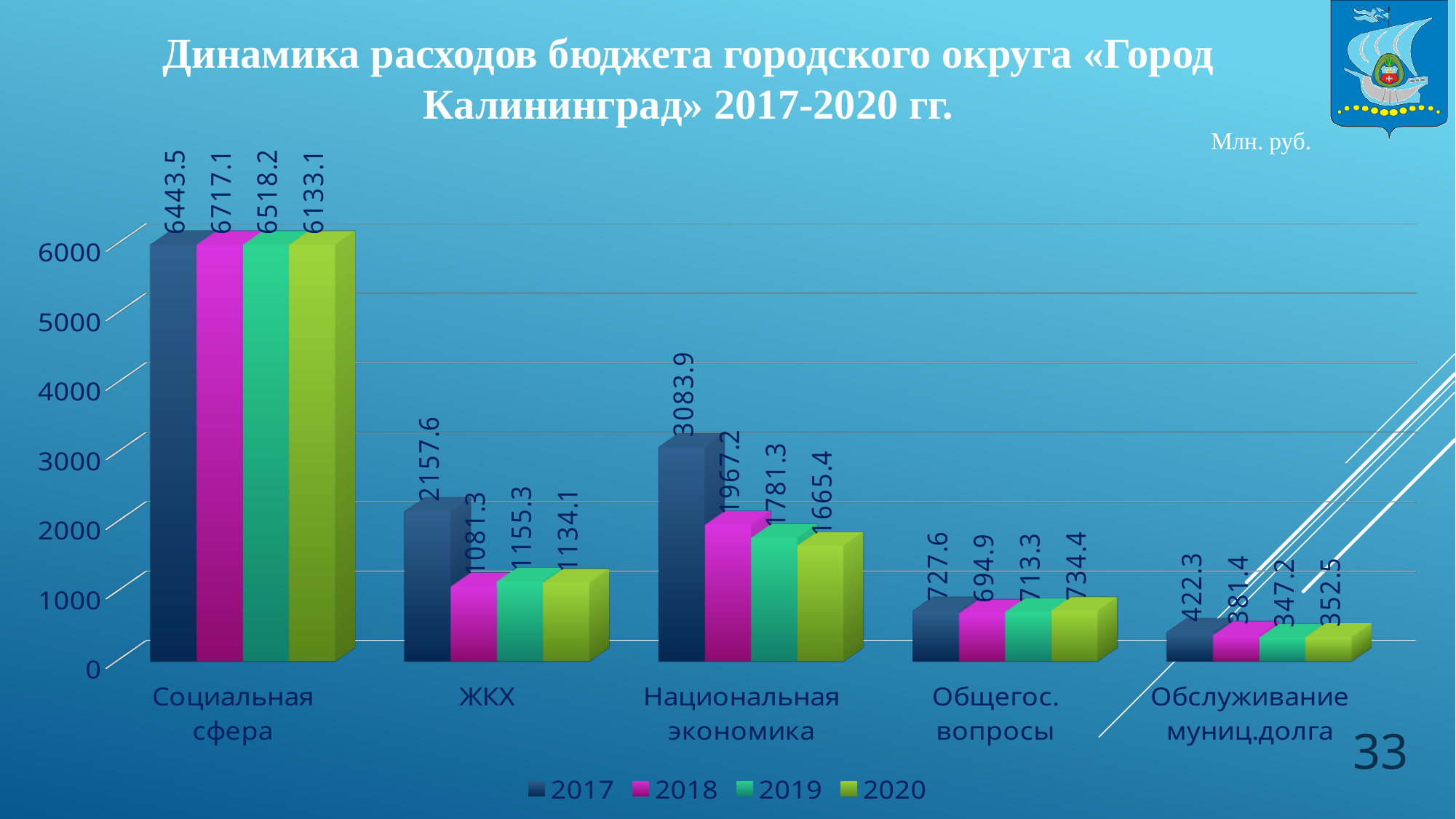
Which category has the highest value in 2017? Социальная сфера Do the values for Национальная экономика rise or fall from 2017 to 2020? Fall Which category has the lowest value in 2020? Обслуживание муниц.долга What is the value for Национальная экономика in 2020? 1665.4 What is the value for Обслуживание муниц.долга in 2019? 347.2 What is the value for ЖКХ in 2017? 2157.6 What is the difference between the 2017 and 2018 values for ЖКХ? 1076.3 Which is larger for Общегос. вопросы: the 2017 value or the 2020 value? 2020 How many series does the legend list? 4 What is the value for Социальная сфера in 2018? 6717.1 How many categories are shown on the x axis? 5 What kind of chart is shown on the slide? Bar chart